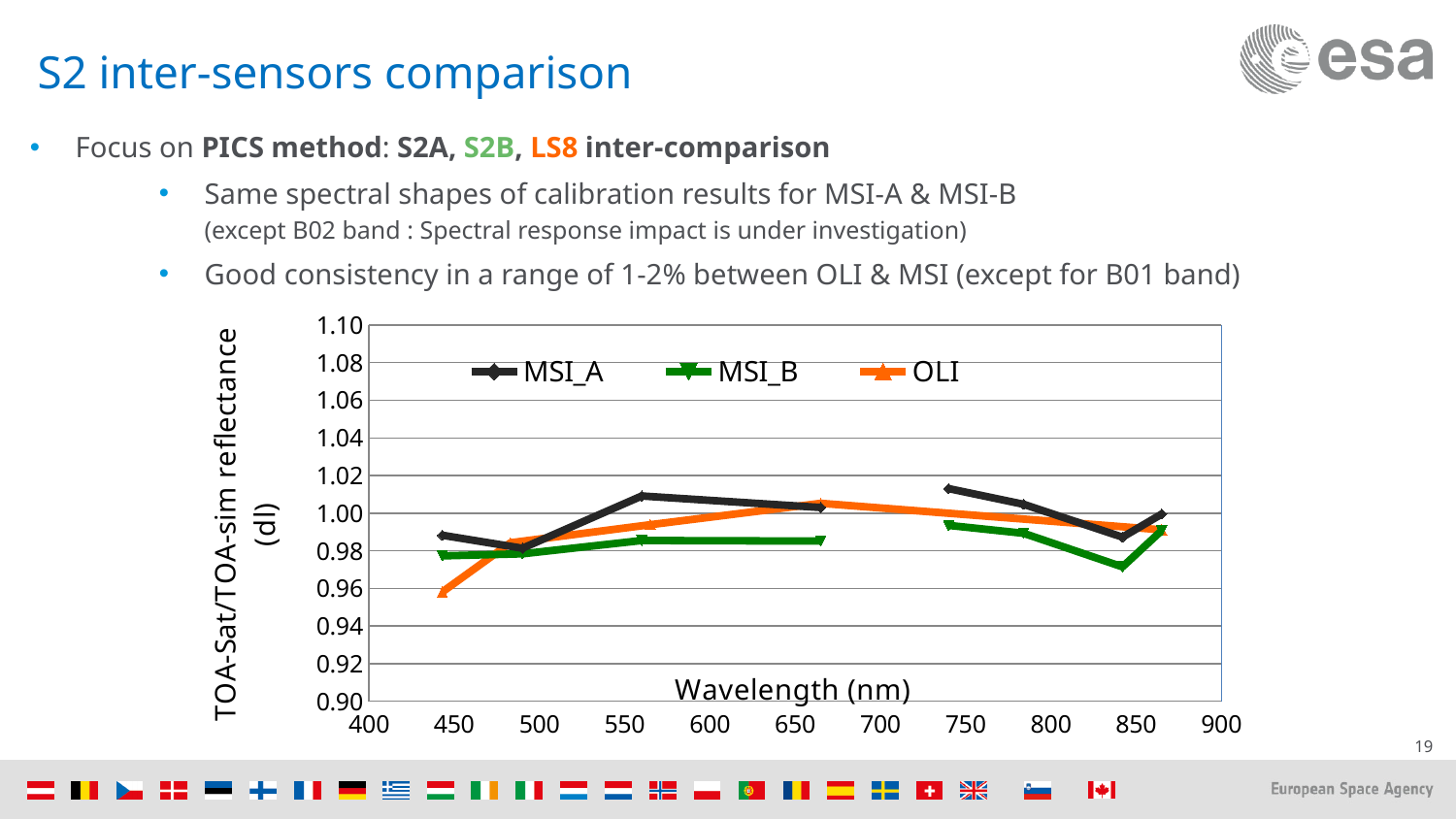
Does the OLI series rise or fall between about 450 nm and 650 nm? rise What are the series names listed in the chart legend? MSI_A, MSI_B, OLI What kind of chart is shown on the slide? Line chart Is the MSI_B value at around 840 nm greater or less than 0.98? less Is the MSI_B value at around 665 nm greater or less than 1.00? less What is the label of the x axis of the chart? Wavelength (nm) At the lowest wavelength (around 450 nm), which series has the larger value, MSI_A or OLI? MSI_A At around 740 nm, which series has the larger value, MSI_A or MSI_B? MSI_A Which series has the lowest value at the lowest wavelength (around 450 nm)? OLI Is the MSI_A value at around 740 nm greater or less than 1.00? greater How many series does the chart legend list? 3